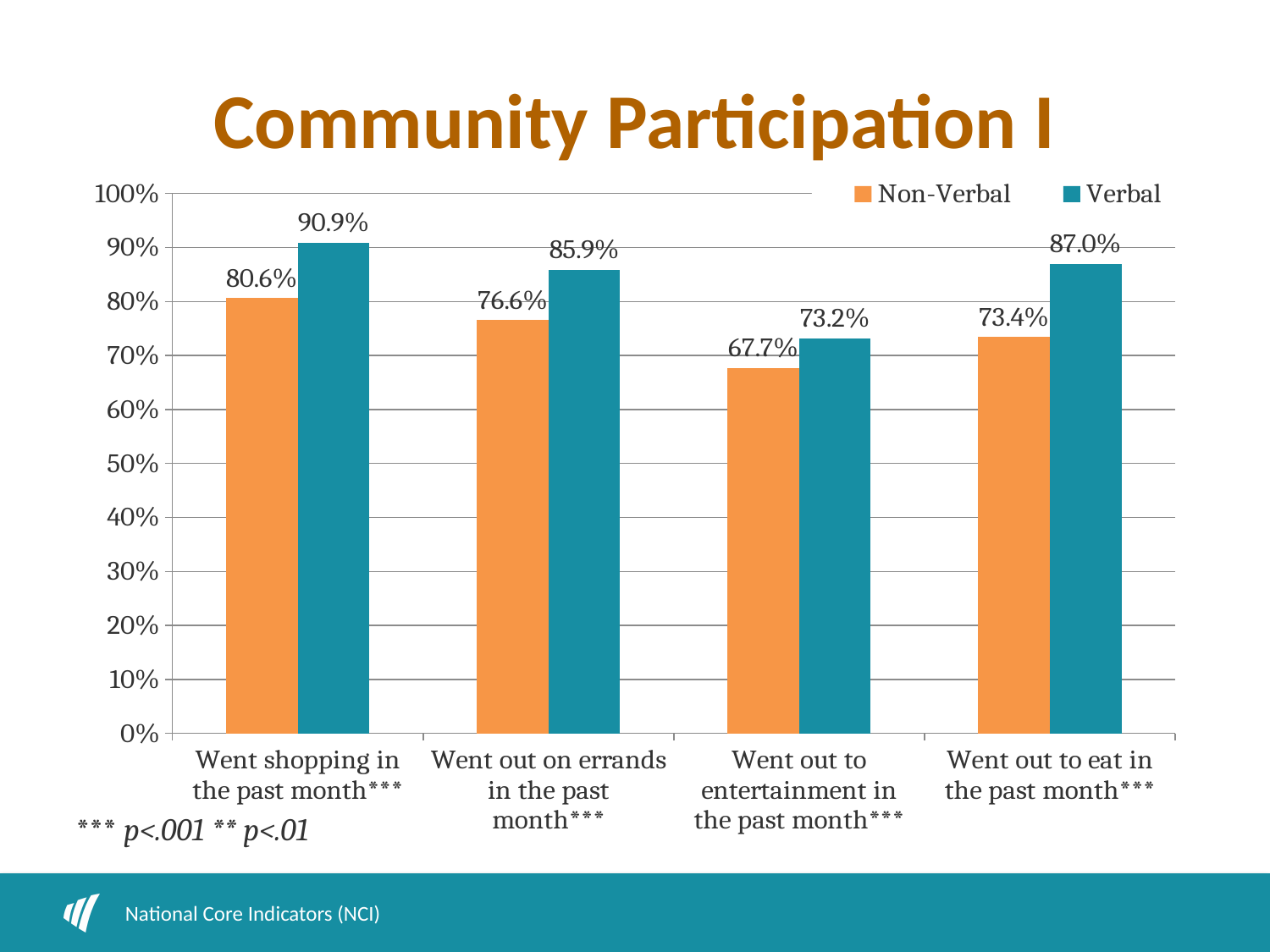
What is the Verbal value for 'Went out to eat in the past month'? 87.0% What is the Non-Verbal value for 'Went shopping in the past month'? 80.6% Which category has the highest Verbal value? Went shopping in the past month Which is larger: the Non-Verbal value for 'Went out on errands in the past month' or the Non-Verbal value for 'Went out to eat in the past month'? Went out on errands in the past month Is the Non-Verbal value for 'Went out to entertainment in the past month' greater or less than 70%? less What is the Verbal value for 'Went out to entertainment in the past month'? 73.2% What is the difference between the Verbal and Non-Verbal values for 'Went shopping in the past month'? 10.3% How many series does the legend list? 2 What is the difference between the Verbal and Non-Verbal values for 'Went out to eat in the past month'? 13.6% How many categories are shown on the x axis? 4 What kind of chart is shown on the slide? bar chart Which category has the lowest Non-Verbal value? Went out to entertainment in the past month